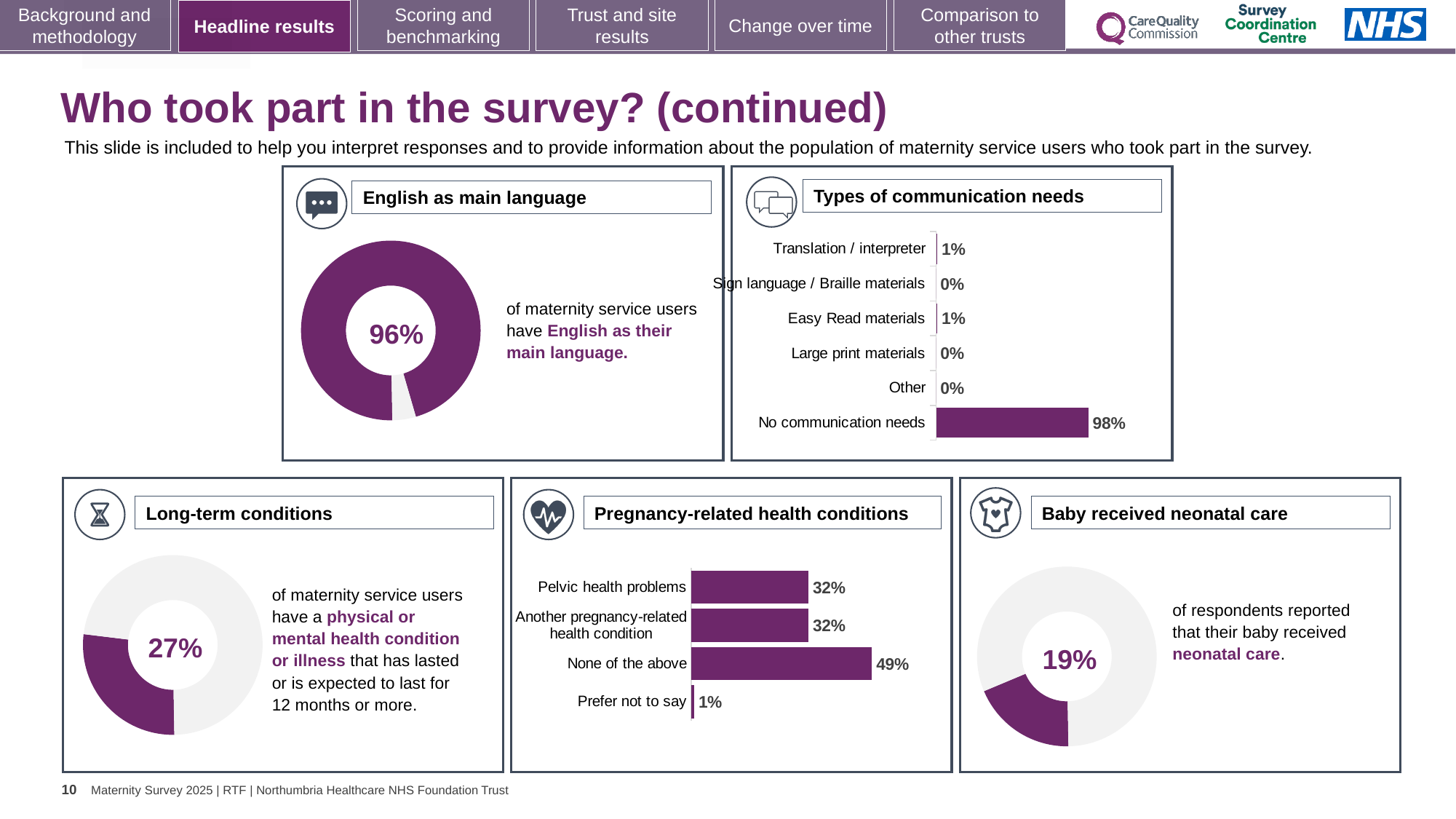
In the 'Pregnancy-related health conditions' chart, what is the value for 'None of the above'? 49% In the 'Baby received neonatal care' chart, what percentage of respondents reported that their baby received neonatal care? 19% In the 'Types of communication needs' chart, which category has the highest value? No communication needs In the 'English as main language' chart, what percentage of maternity service users have English as their main language? 96% How many categories are shown in the 'Types of communication needs' chart? 6 In the 'Long-term conditions' chart, what percentage of maternity service users have a physical or mental health condition or illness? 27% In the 'Pregnancy-related health conditions' chart, what is the difference between 'None of the above' and 'Pelvic health problems'? 17% In the 'Pregnancy-related health conditions' chart, which category has the lowest value? Prefer not to say In the 'Types of communication needs' chart, what is the value for 'Translation / interpreter'? 1% How many categories are shown in the 'Pregnancy-related health conditions' chart? 4 In the 'Types of communication needs' chart, what is the value for 'No communication needs'? 98% What kind of chart is the 'Types of communication needs' chart? Bar chart